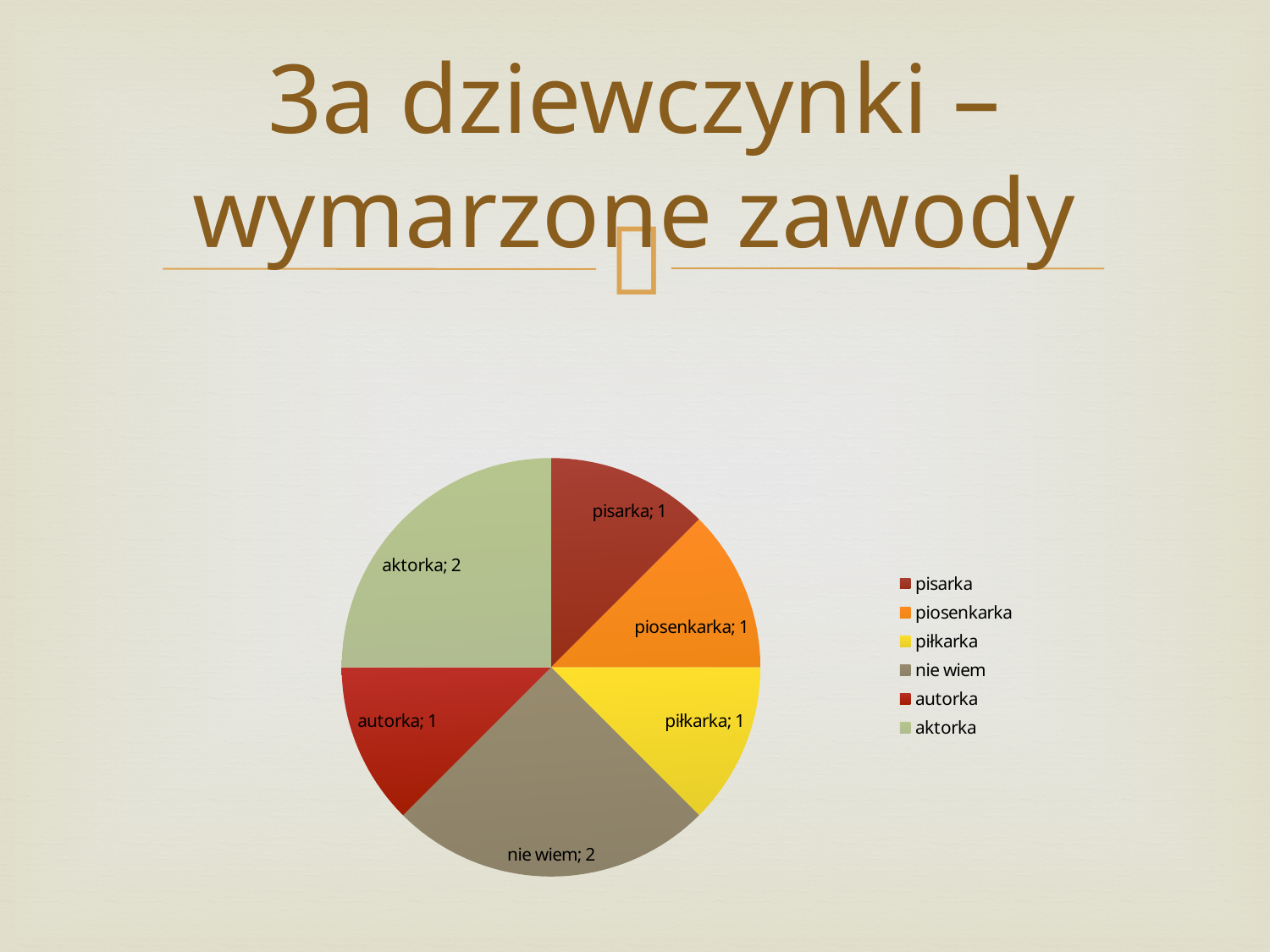
What kind of chart is shown on the slide? pie chart What share of the pie does the pisarka slice represent? 12.5% Which is larger, the value for aktorka or the value for autorka? aktorka What is the value for piosenkarka? 1 What is the difference between the value for nie wiem and the value for pisarka? 1 What share of the pie does the aktorka slice represent? 25% How many slices does the pie chart have? 6 How many entries does the legend list? 6 What is the value for piłkarka? 1 What is the value for aktorka? 2 What is the value for nie wiem? 2 Which two categories share the highest value in the pie chart? nie wiem and aktorka